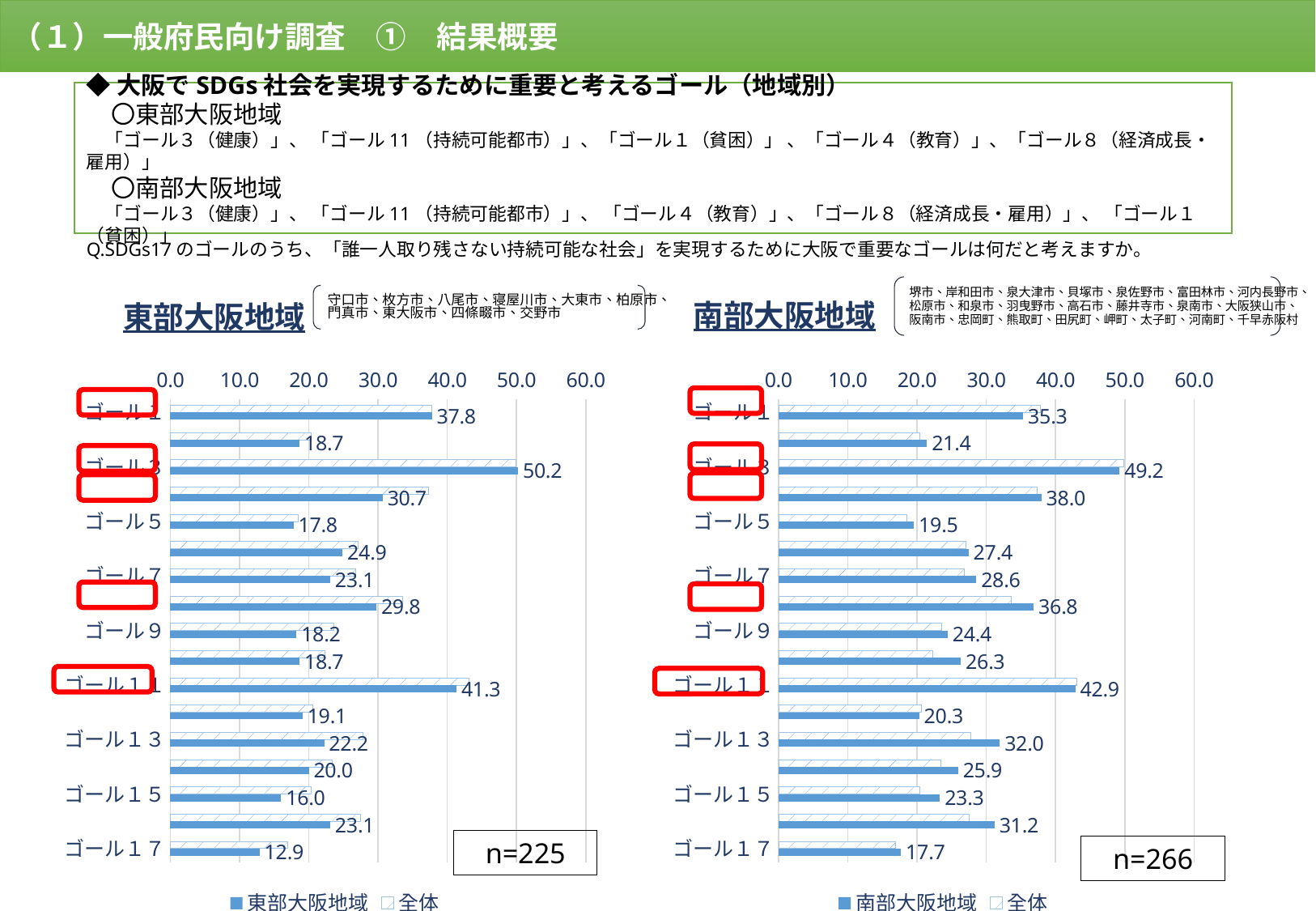
What type of chart is used for the 東部大阪地域 data? Bar chart In the 東部大阪地域 chart, which goal has the highest labelled value? ゴール3 In the 南部大阪地域 chart, what value is labelled for ゴール11? 42.9 In the 南部大阪地域 chart, which goal has the lowest labelled value? ゴール17 What sample size (n) is shown for the 南部大阪地域 chart? n=266 In the 南部大阪地域 chart, is the labelled value for ゴール13 greater or less than 30.0? greater How many series does the legend of the 南部大阪地域 chart list? 2 In the 東部大阪地域 chart, which has the larger labelled value, ゴール1 or ゴール11? ゴール11 In the 東部大阪地域 chart, what is the difference between the labelled values for ゴール3 and ゴール11? 8.9 In the 南部大阪地域 chart, what is the difference between the labelled values for ゴール3 and ゴール1? 13.9 In the 東部大阪地域 chart, what value is labelled for ゴール3? 50.2